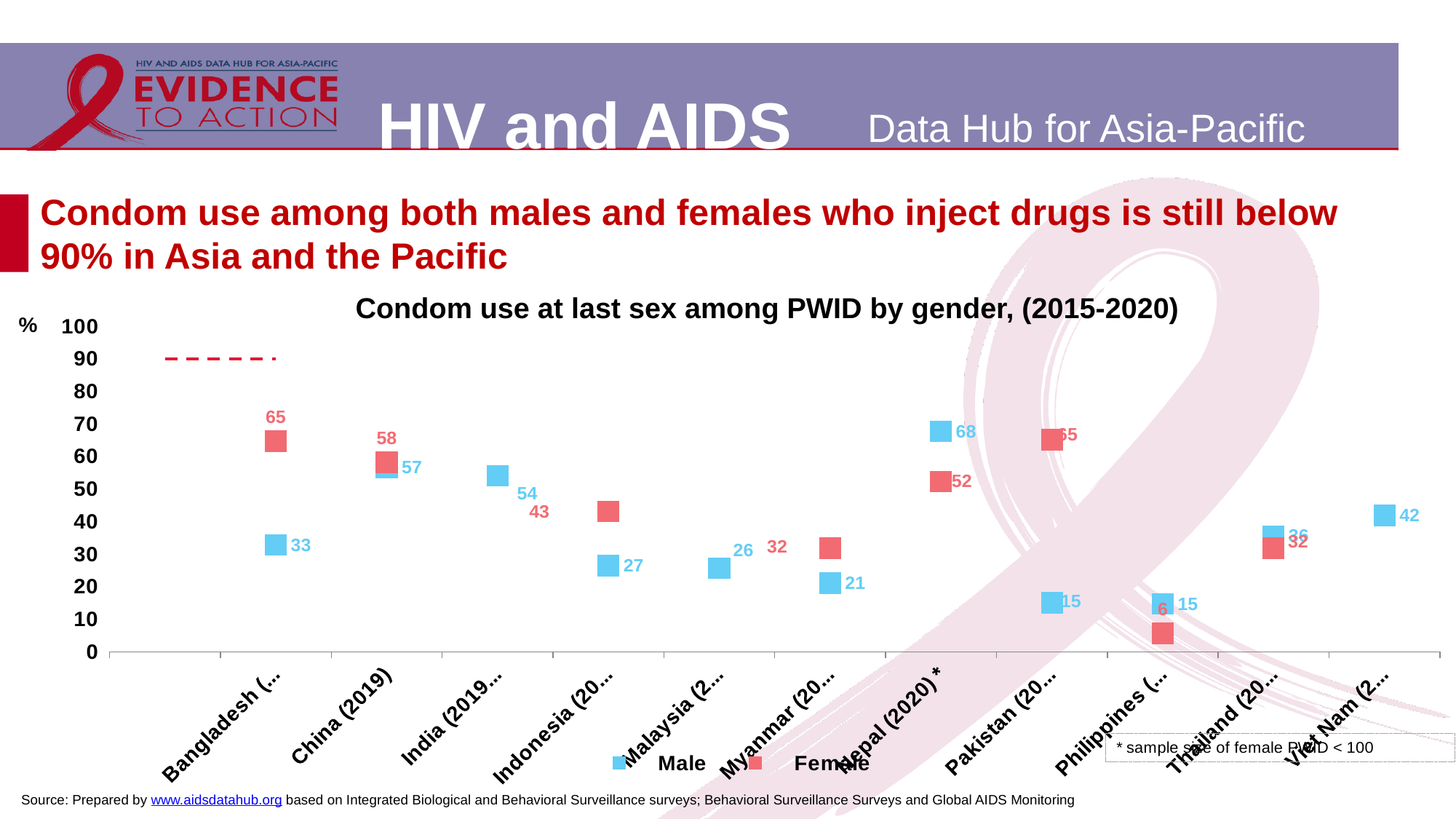
Which country has the lowest Female value? Philippines For Nepal (2020), which is larger, the Male or the Female value? Male How many series does the legend list? 2 What is the Male value for Bangladesh? 33 At what value on the y axis is the dashed red reference line drawn? 90 What is the Female value for Pakistan? 65 What is the Female value for Philippines? 6 What is the difference between the Female and Male values for Bangladesh? 32 What is the Male value for Nepal (2020)? 68 Which country has the highest Male value? Nepal (2020) What is the difference between the Female and Male values for Pakistan? 50 How many countries are shown on the x axis? 11